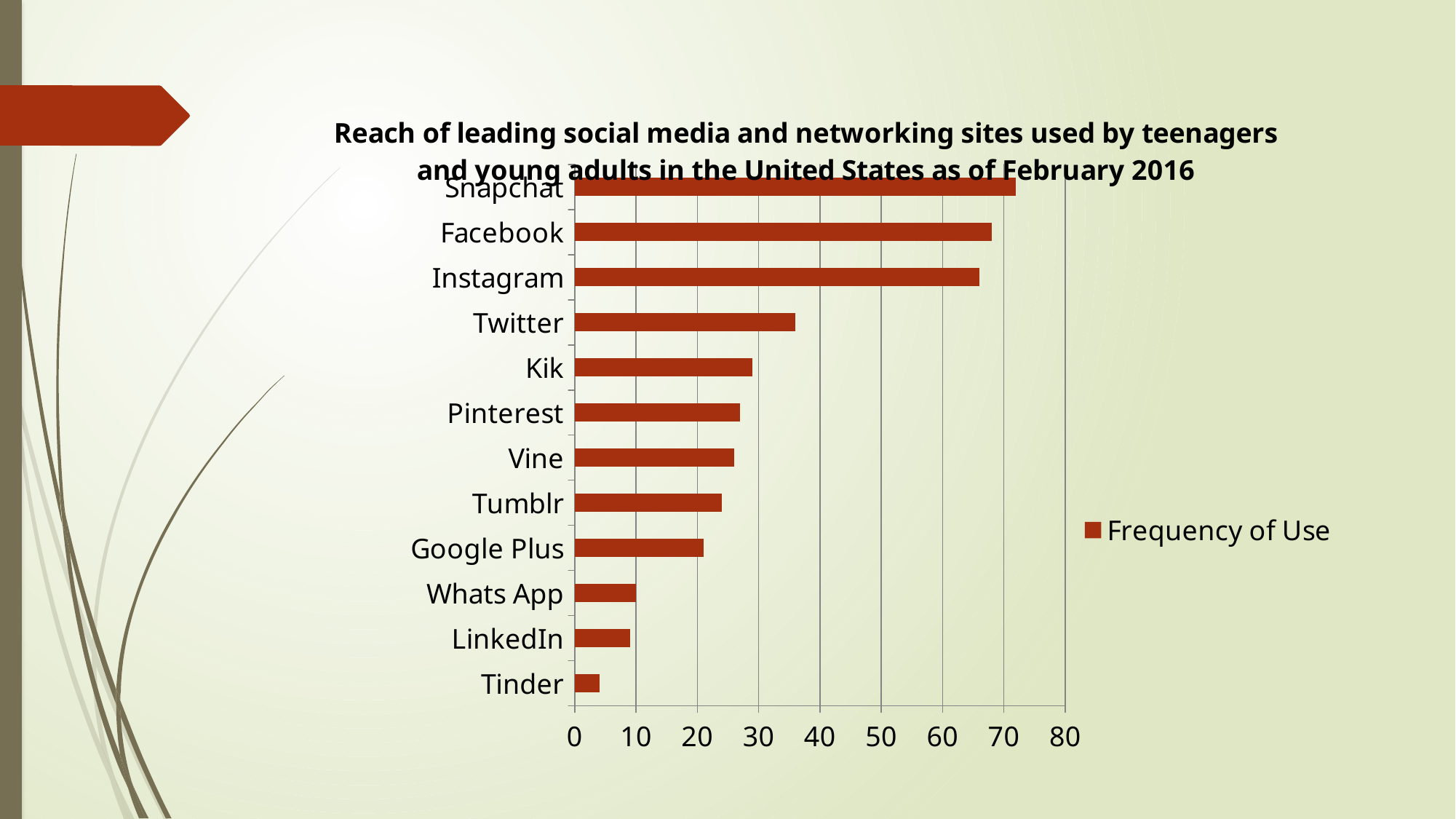
What is the name of the series shown in the legend? Frequency of Use Which social media site has the highest value in the chart? Snapchat Which has the larger value, Twitter or Kik? Twitter Which social media site has the lowest value in the chart? Tinder How many social media sites are listed in the chart? 12 Is the value for Twitter greater or less than 40? less What kind of chart is shown on the slide? bar chart Is the value for Snapchat greater or less than 70? greater Which has the larger value, Google Plus or Tumblr? Tumblr How many series does the legend list? 1 Is the value for Tinder greater or less than 10? less